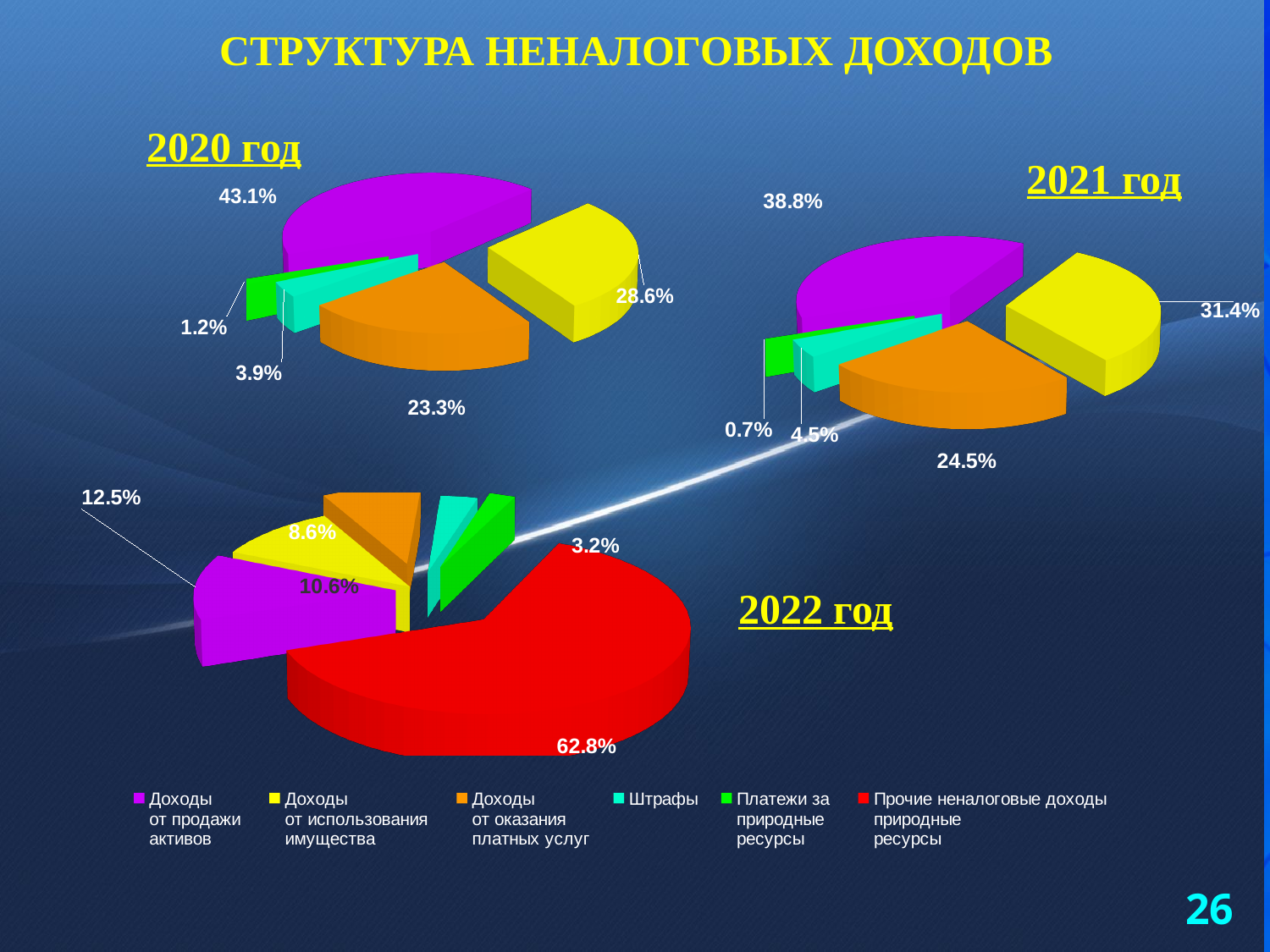
In the 2022 год pie chart, which category has the largest share? Прочие неналоговые доходы What type of chart is used for the 2022 год data? Pie chart In the 2020 год pie chart, what is the difference between the shares of Доходы от продажи активов and Доходы от использования имущества? 14.5% In the 2020 год pie chart, what share is shown for Доходы от продажи активов (purple slice)? 43.1% In the 2021 год pie chart, which category has the smallest share? Платежи за природные ресурсы Which is larger in the 2021 год pie chart: the share of Доходы от оказания платных услуг or the share of Доходы от использования имущества? Доходы от использования имущества How many slices does the 2020 год pie chart have? 5 In the 2022 год pie chart, what share is shown for Прочие неналоговые доходы (red slice)? 62.8% In the 2021 год pie chart, what share is shown for Штрафы (cyan slice)? 4.5% How many categories does the legend at the bottom of the slide list? 6 In the 2021 год pie chart, what share is shown for Доходы от использования имущества (yellow slice)? 31.4% In the 2020 год pie chart, which category has the largest share? Доходы от продажи активов